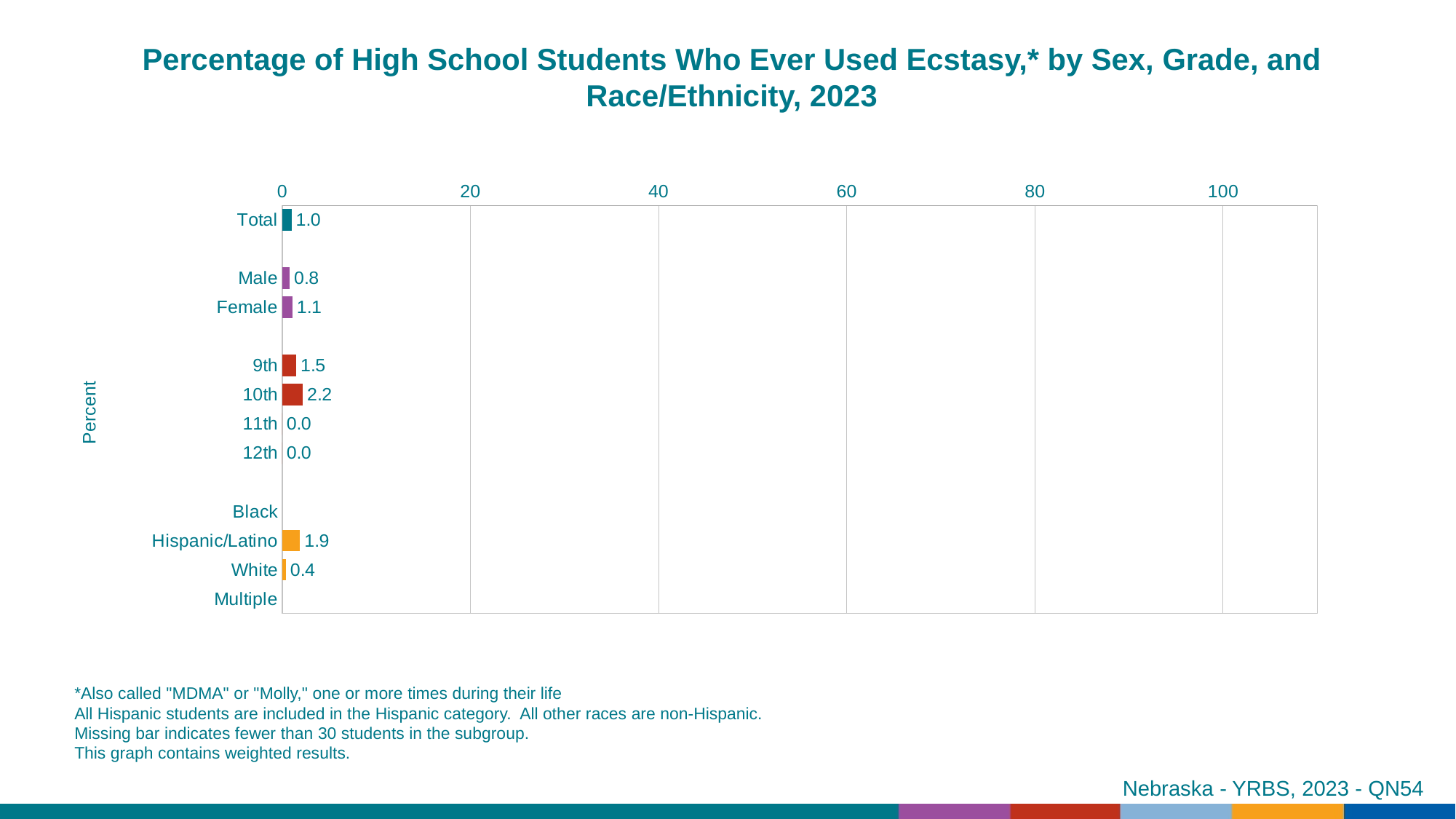
Which is larger, the value for Male or the value for Female? Female What is the value for 10th grade? 2.2 What kind of chart is shown on the slide? Bar chart What is the value for Female? 1.1 What is the value for White? 0.4 What is the difference between the values for 10th and 9th grade? 0.7 What is the difference between the values for Hispanic/Latino and White? 1.5 What is the value for Total? 1.0 What is the value for Hispanic/Latino? 1.9 What is the value for 11th grade? 0.0 Which categories have no bar shown? Black and Multiple Which grade has the highest value? 10th